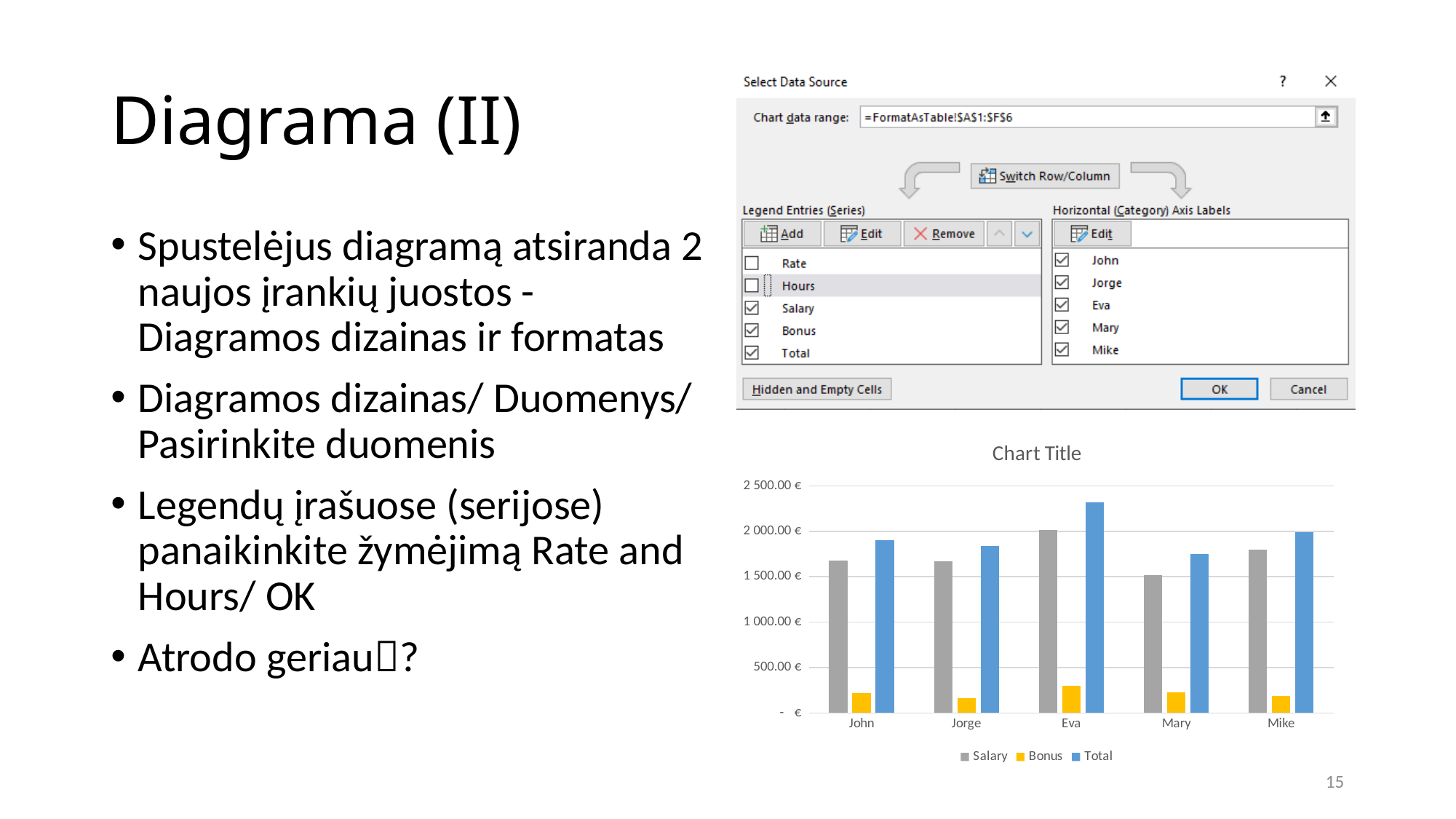
How many series does the chart legend list? 3 Which is larger, the Bonus value for Eva or the Bonus value for Jorge? Eva Which category has the highest Salary value? Eva How many categories are shown on the x axis of the chart? 5 What kind of chart is shown on the slide? bar chart Which category has the lowest Total value? Mary What is the title of the chart? Chart Title Is the Total value for Mary greater or less than 2 000.00 €? less Which category has the highest Total value? Eva Is the Total value for Eva greater or less than 2 000.00 €? greater Which category has the lowest Salary value? Mary Is the Salary value for Mike greater or less than 1 500.00 €? greater